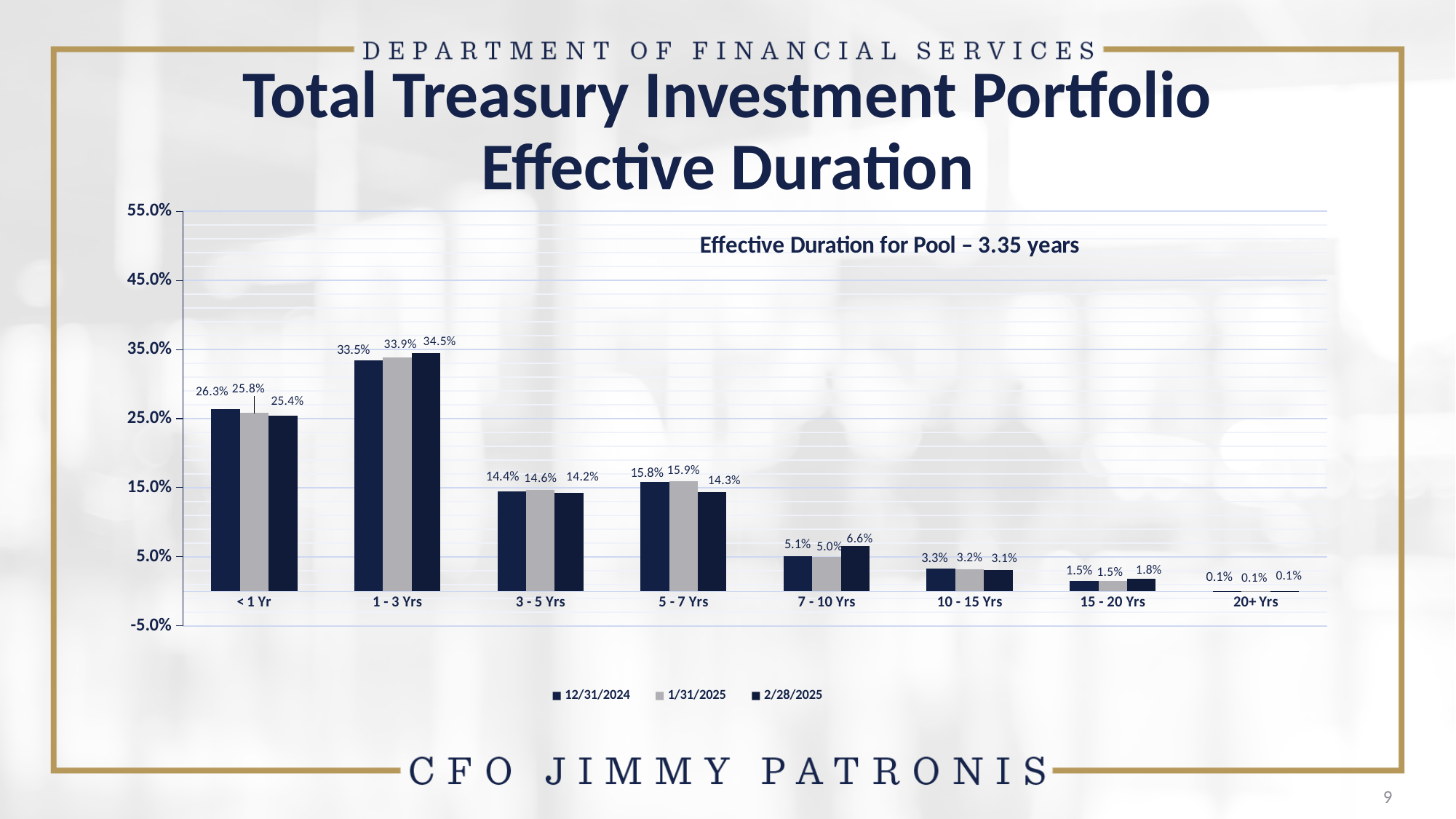
How many maturity categories are shown on the x axis? 8 How many series does the legend list? 3 Which category has the highest value in the 2/28/2025 series? 1 - 3 Yrs What is the value for the 7 - 10 Yrs category in the 1/31/2025 series? 5.0% What is the value for the 1 - 3 Yrs category in the 2/28/2025 series? 34.5% What is the value for the < 1 Yr category in the 12/31/2024 series? 26.3% Is the 1/31/2025 value for the 1 - 3 Yrs category greater or less than 25.0%? greater What is the difference between the 2/28/2025 and 12/31/2024 values for the 7 - 10 Yrs category? 1.5% Which is larger for the 5 - 7 Yrs category: the 12/31/2024 value or the 2/28/2025 value? 12/31/2024 Which category has the lowest value in the 12/31/2024 series? 20+ Yrs What kind of chart is shown on the slide? Bar chart What effective duration for the pool is stated on the chart? 3.35 years